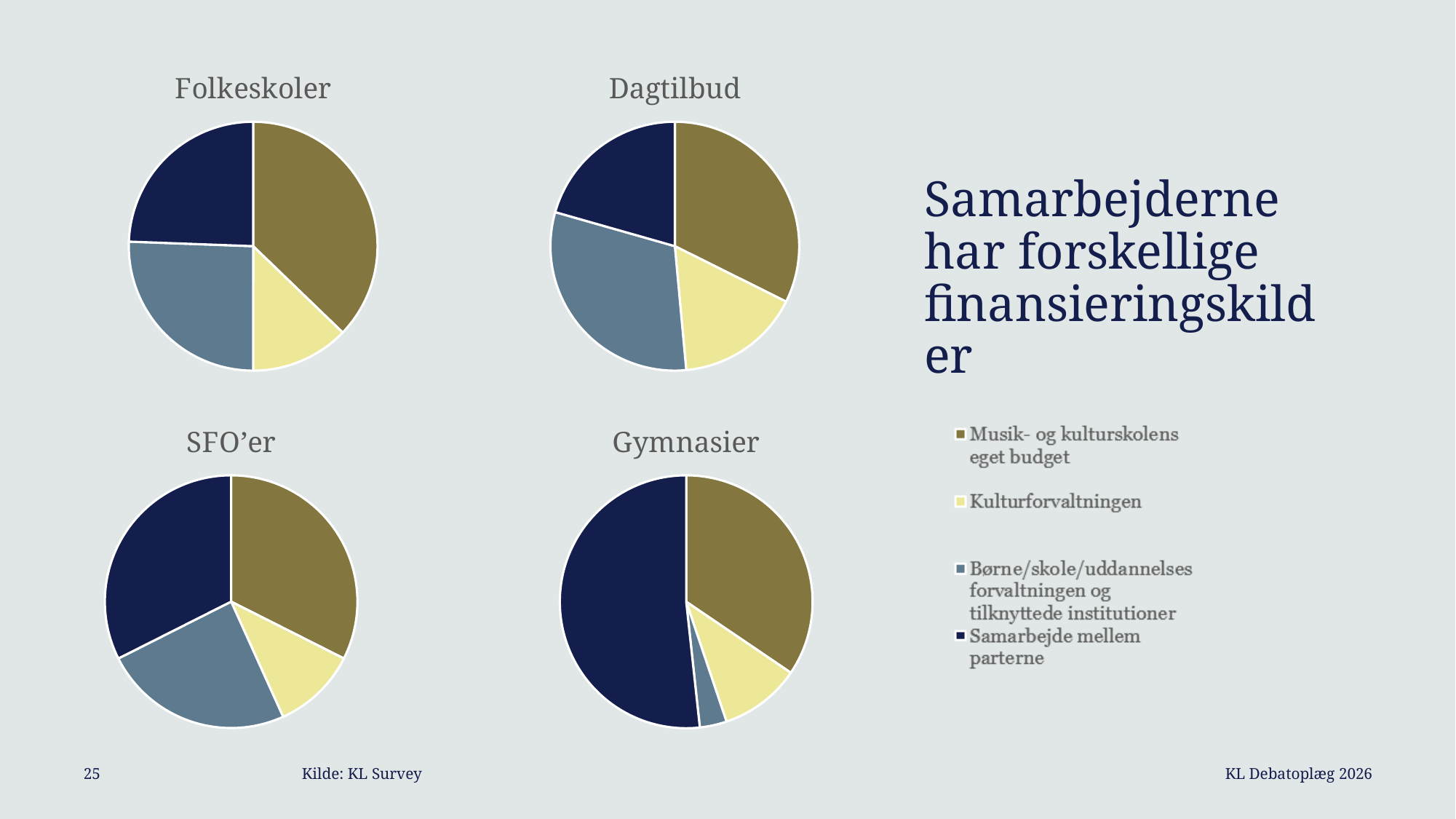
In the Gymnasier chart, which category has the largest slice? Samarbejde mellem parterne In the Folkeskoler chart, which category has the largest slice? Musik- og kulturskolens eget budget In the SFO'er chart, which is larger: Kulturforvaltningen or Børne/skole/uddannelsesforvaltningen og tilknyttede institutioner? Børne/skole/uddannelsesforvaltningen og tilknyttede institutioner How many entries does the legend list? 4 In the SFO'er chart, which category has the smallest slice? Kulturforvaltningen In the Gymnasier chart, which is larger: Samarbejde mellem parterne or Musik- og kulturskolens eget budget? Samarbejde mellem parterne What are the titles of the four pie charts on the slide? Folkeskoler, Dagtilbud, SFO'er, Gymnasier In the Folkeskoler chart, which category has the smallest slice? Kulturforvaltningen What kind of chart is the Folkeskoler chart? Pie chart Which legend entry is shown in light yellow? Kulturforvaltningen In the Gymnasier chart, which category has the smallest slice? Børne/skole/uddannelsesforvaltningen og tilknyttede institutioner How many slices does the Gymnasier pie chart have? 4